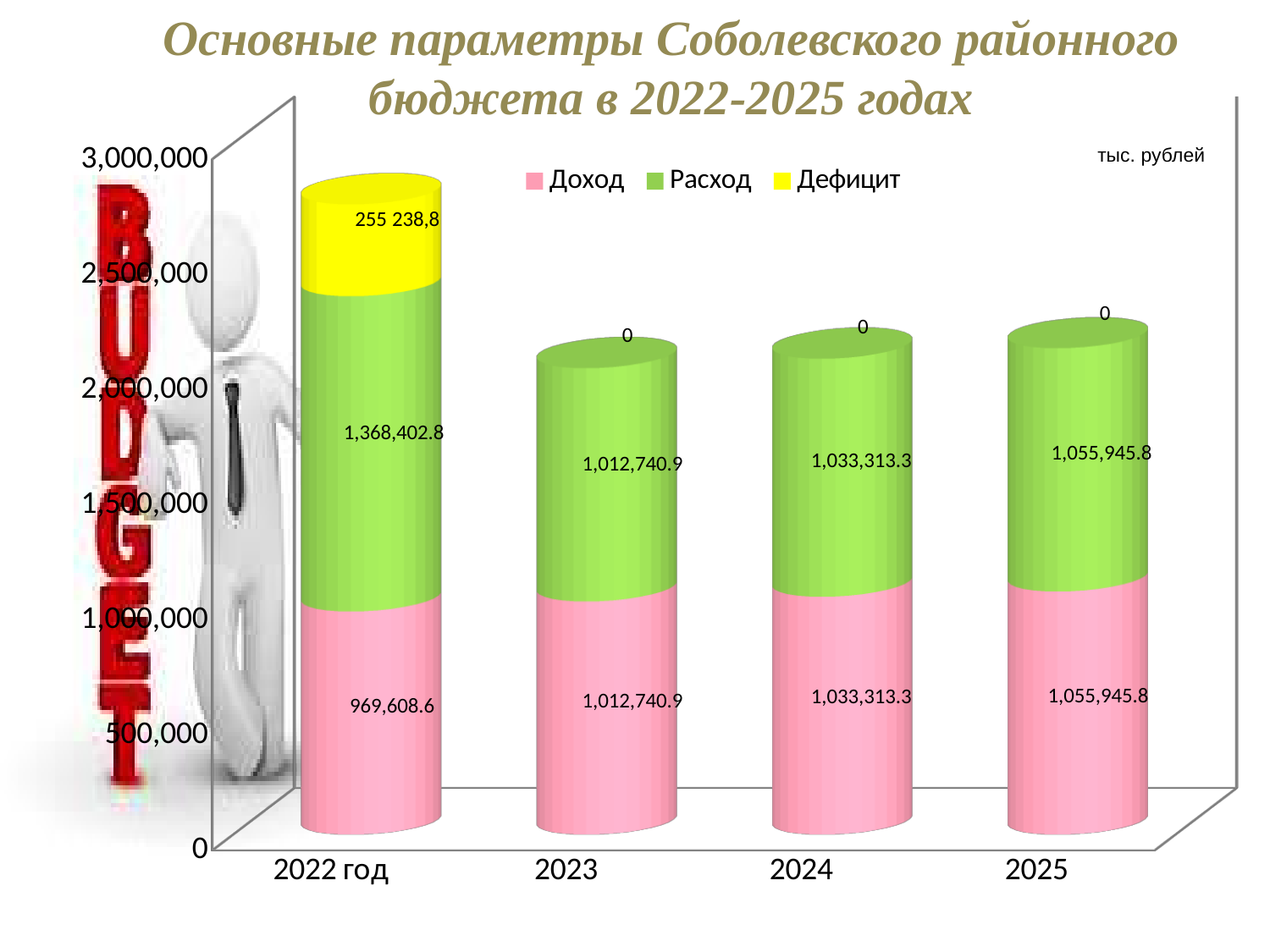
What kind of chart is shown on the slide? Stacked bar chart Which year has the lowest Доход value? 2022 год How many years are shown on the x axis? 4 What is the difference between Расход and Доход in 2022 год? 398,794.2 What is the Дефицит value for 2022 год? 255 238,8 What is the total of the stacked bar for 2025? 2,111,891.6 What is the Доход value for 2023? 1,012,740.9 Which year has the highest Расход value? 2022 год What is the Дефицит value for 2024? 0 Is the Доход value for 2025 larger than the Доход value for 2023? Yes What is the Расход value for 2022 год? 1,368,402.8 How many series does the legend list? 3